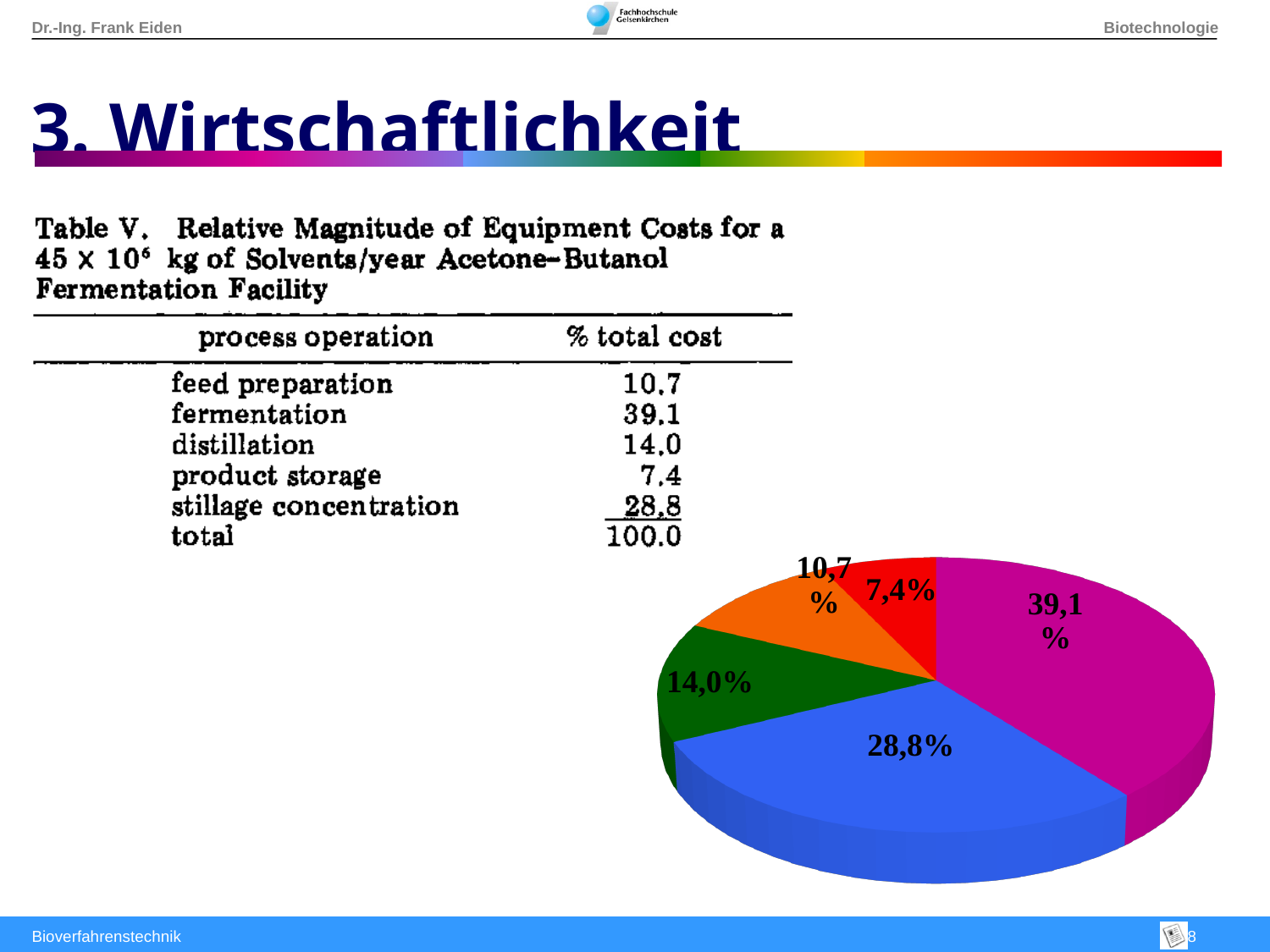
What value is shown on the green slice of the pie chart? 14,0% What is the value of the largest slice of the pie chart? 39,1% What is the value of the smallest slice of the pie chart? 7,4% What colour is the largest slice of the pie chart? magenta What value is shown on the orange slice of the pie chart? 10,7% How many slices does the pie chart have? 5 What value is shown on the red slice of the pie chart? 7,4% Which slice is larger in the pie chart, the green slice or the orange slice? the green slice (14,0%) What value is shown on the blue slice of the pie chart? 28,8% What kind of chart is shown on the slide? pie chart What is the difference between the largest slice (39,1%) and the blue slice (28,8%) in the pie chart? 10,3% According to the table on the slide, which process operation does the 39,1% slice of the pie chart correspond to? fermentation